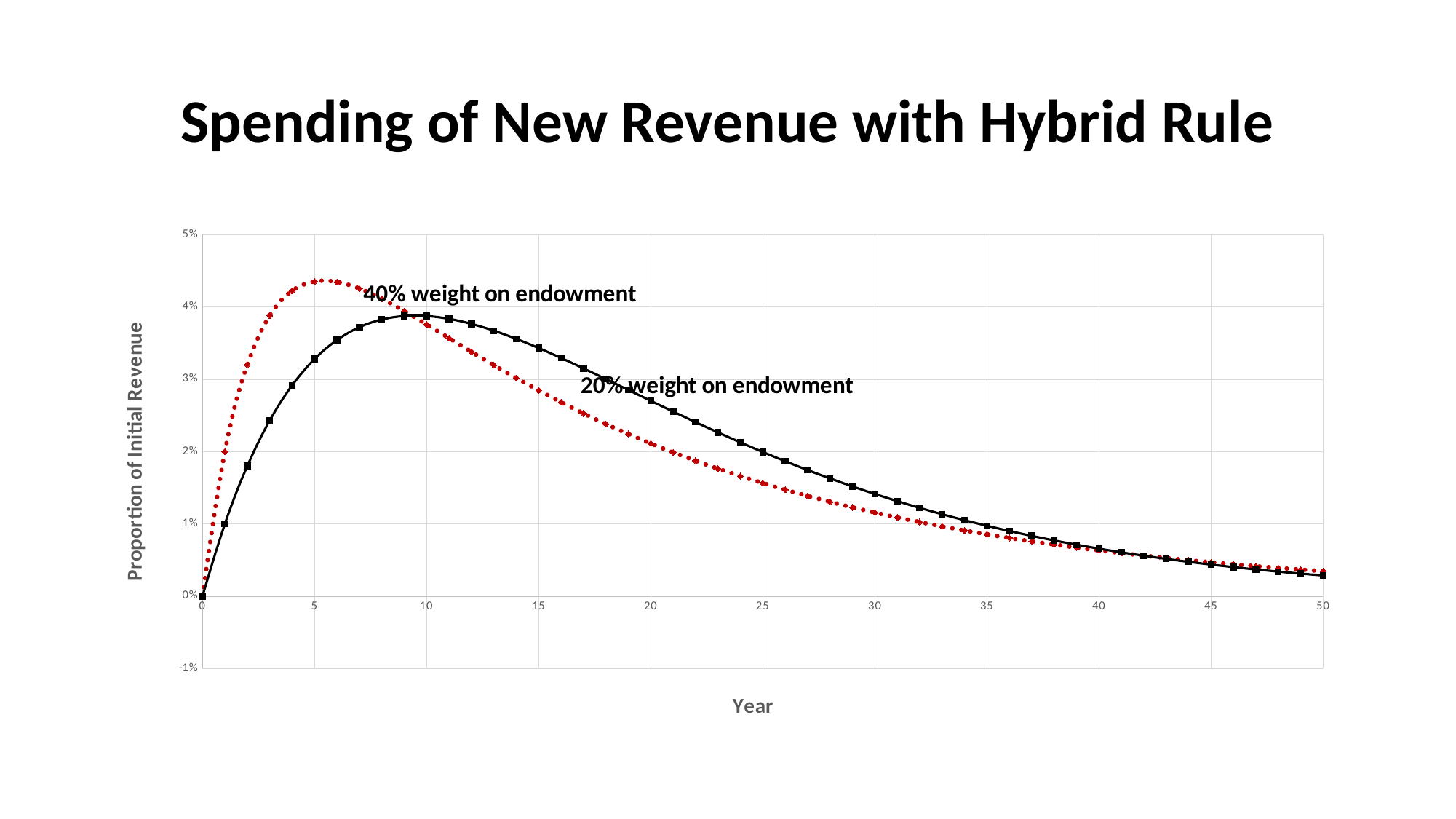
Is the value for the 20% weight on endowment series at year 5 greater or less than 4%? less Is the value for the 20% weight on endowment series at year 20 greater or less than 2%? greater At year 5, which series has the higher value? 40% weight on endowment How many series are plotted on the chart? 2 Which series reaches the higher peak value? 40% weight on endowment Is the value for the 40% weight on endowment series at year 40 greater or less than 1%? less What is the value of the 20% weight on endowment series at year 0? 0% What is the label of the vertical axis? Proportion of Initial Revenue What is the title of the chart? Spending of New Revenue with Hybrid Rule At year 20, which series has the higher value? 20% weight on endowment What kind of chart is shown on the slide? line chart